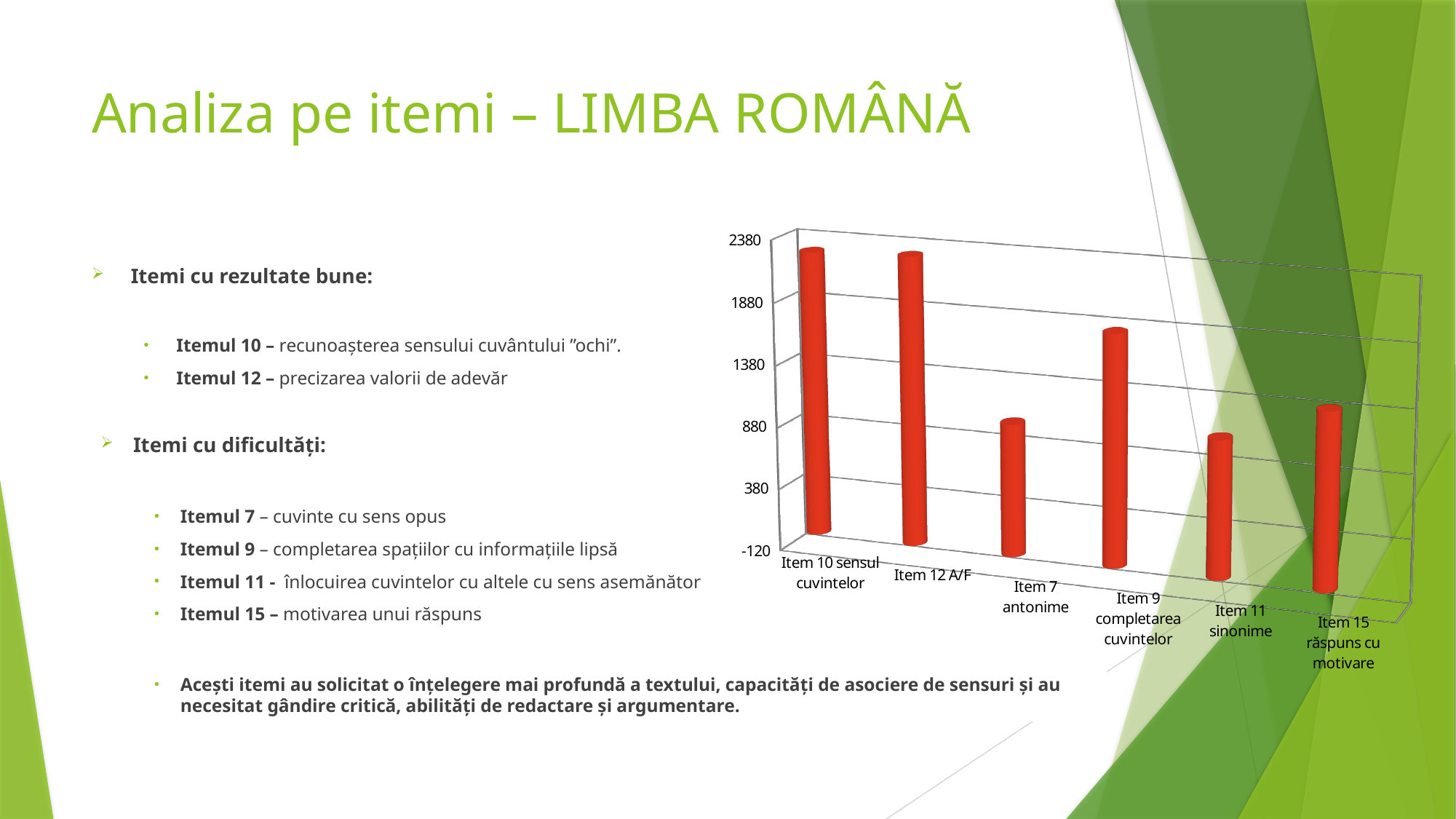
Is the value for Item 9 completarea cuvintelor greater or less than 1380? greater Is the value for Item 7 antonime greater or less than 1380? less What is the highest value shown on the chart's vertical axis? 2380 Which has the larger value, Item 9 completarea cuvintelor or Item 11 sinonime? Item 9 completarea cuvintelor Which has the larger value, Item 12 A/F or Item 15 răspuns cu motivare? Item 12 A/F What kind of chart is shown on the slide? bar chart Which has the larger value, Item 10 sensul cuvintelor or Item 7 antonime? Item 10 sensul cuvintelor Is the value for Item 10 sensul cuvintelor greater or less than 1880? greater How many items (categories) are plotted in the chart? 6 What colour are the bars in the chart? red